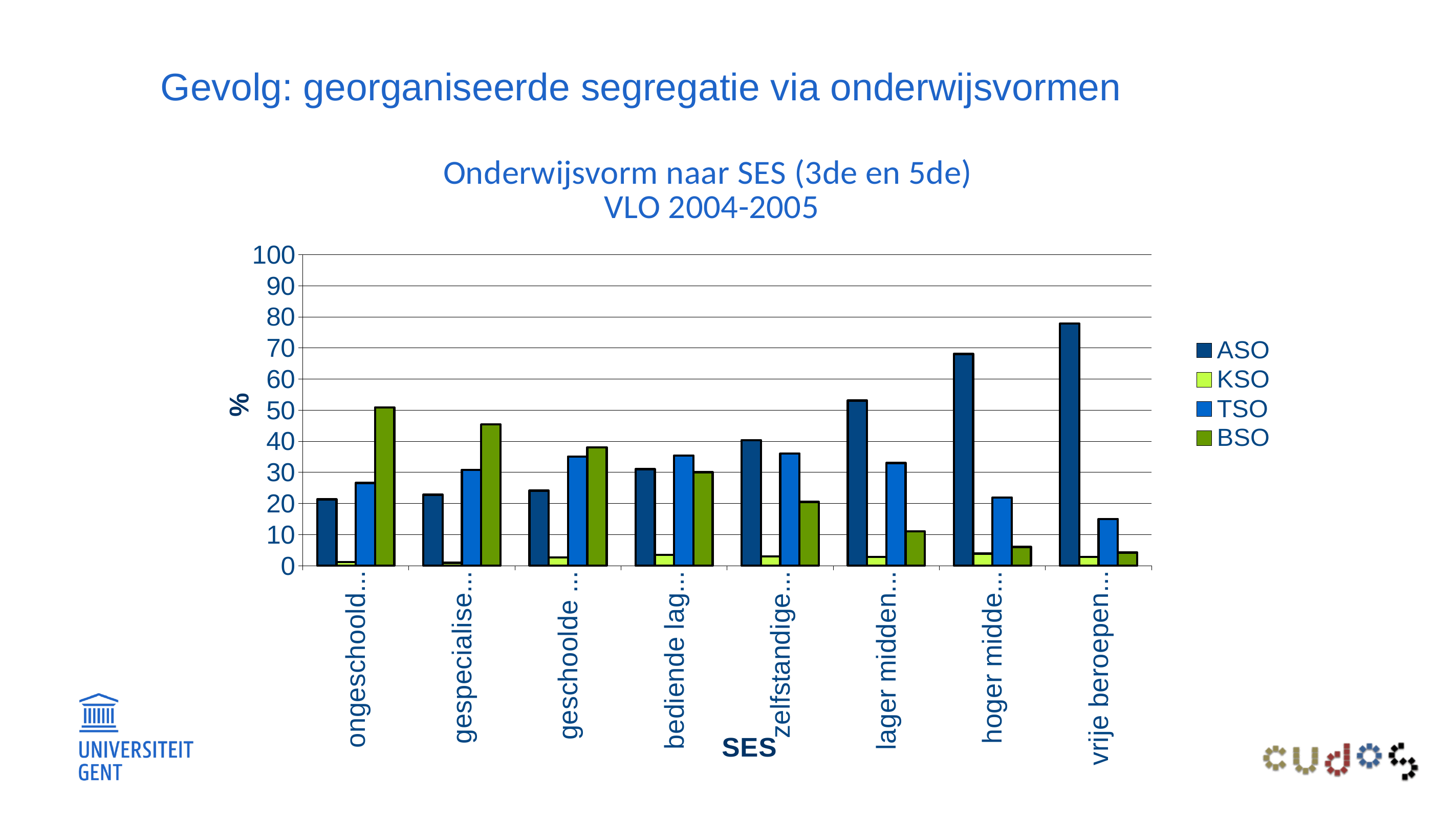
For hoger midde..., which is larger: the ASO bar or the TSO bar? ASO Is the BSO value for ongeschoold... greater or less than 40? greater Do the ASO bars generally rise or fall from left to right along the x axis? rise Which series has the lowest bars in every category? KSO Is the TSO value for vrije beroepen... greater or less than 20? less Which series has the tallest bar for the first category (ongeschoold...)? BSO What is the label on the y axis of the chart? % Which series has the tallest bar for the last category (vrije beroepen...)? ASO How many series does the legend list? 4 How many SES categories are shown along the x axis? 8 What kind of chart is shown on the slide? bar chart Is the ASO value for vrije beroepen... greater or less than 70? greater